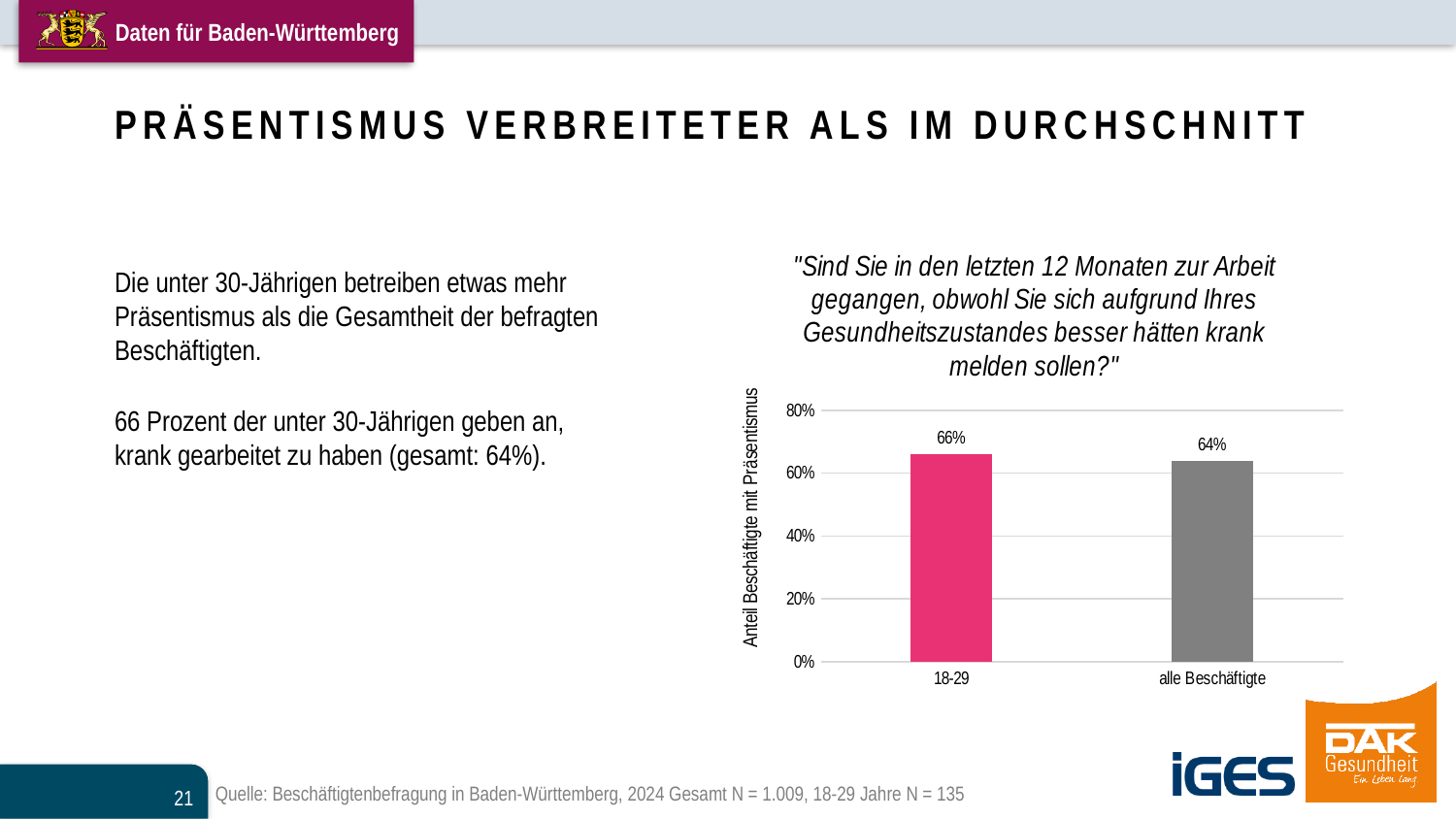
Is the value for alle Beschäftigte greater or less than 80%? less What is the label of the y axis of the chart? Anteil Beschäftigte mit Präsentismus What is the difference between the value for 18-29 and the value for alle Beschäftigte? 2 percentage points What is the value for the 18-29 category? 66% What is the highest value shown on the y axis of the chart? 80% How many categories are shown on the x axis of the chart? 2 Which category has the lower value? alle Beschäftigte What is the value for alle Beschäftigte? 64% Is the value for 18-29 greater or less than 60%? greater What kind of chart is shown on the slide? Bar chart Which category has the higher value? 18-29